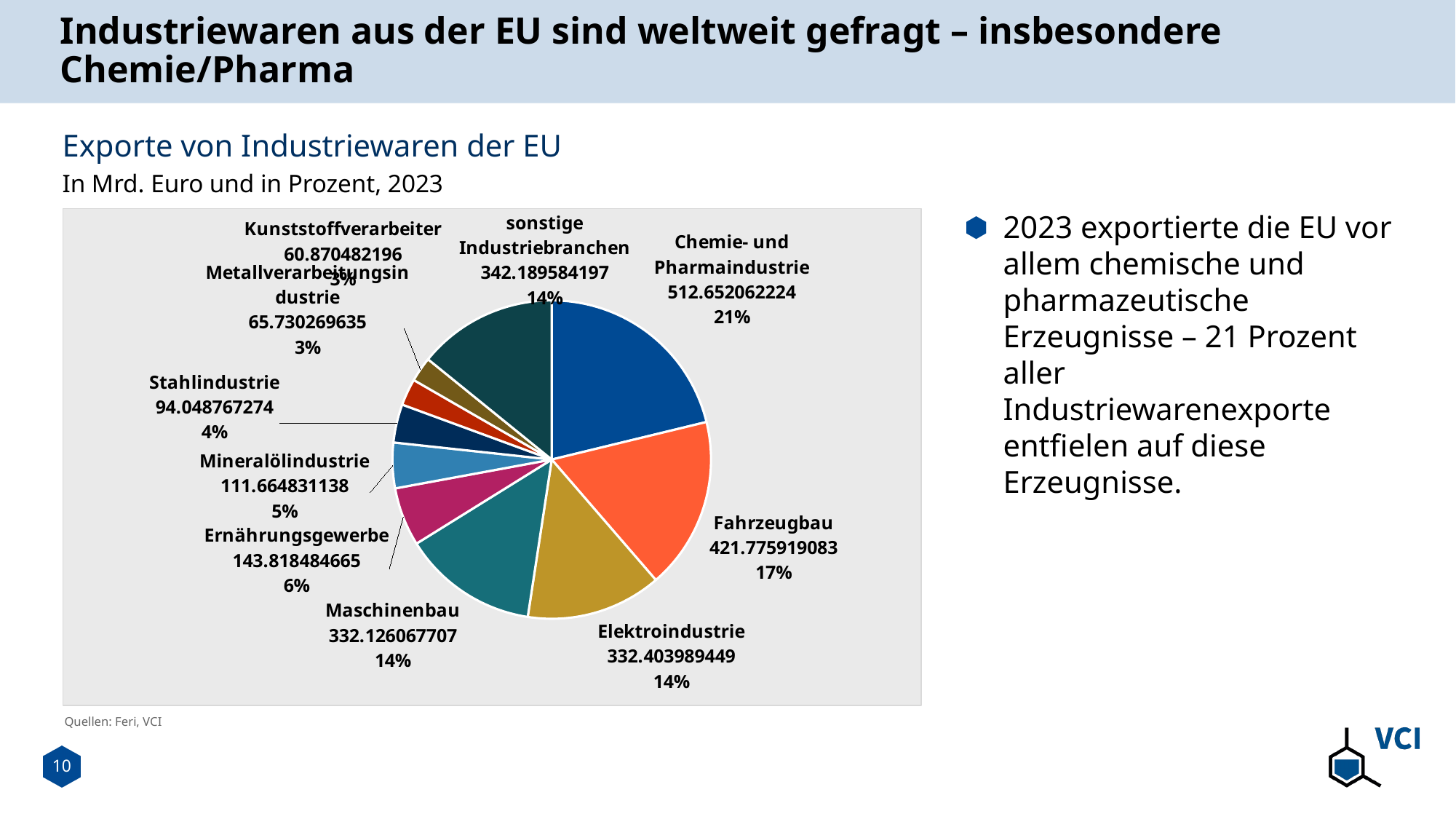
Which category has the smallest slice of the pie? Kunststoffverarbeiter What percentage is shown for Ernährungsgewerbe? 6% What kind of chart is shown on the slide? Pie chart Which category has the largest slice of the pie? Chemie- und Pharmaindustrie How many categories (slices) does the pie chart show? 10 What share of the pie does Fahrzeugbau account for? 17% What is the export value shown for Stahlindustrie? 94.048767274 What is the difference in percentage points between the shares of Chemie- und Pharmaindustrie and Fahrzeugbau? 4 percentage points What is the export value shown for sonstige Industriebranchen? 342.189584197 What is the title of the chart? Exporte von Industriewaren der EU Which is larger, the export value for Fahrzeugbau or for Elektroindustrie? Fahrzeugbau What is the export value shown for Chemie- und Pharmaindustrie? 512.652062224